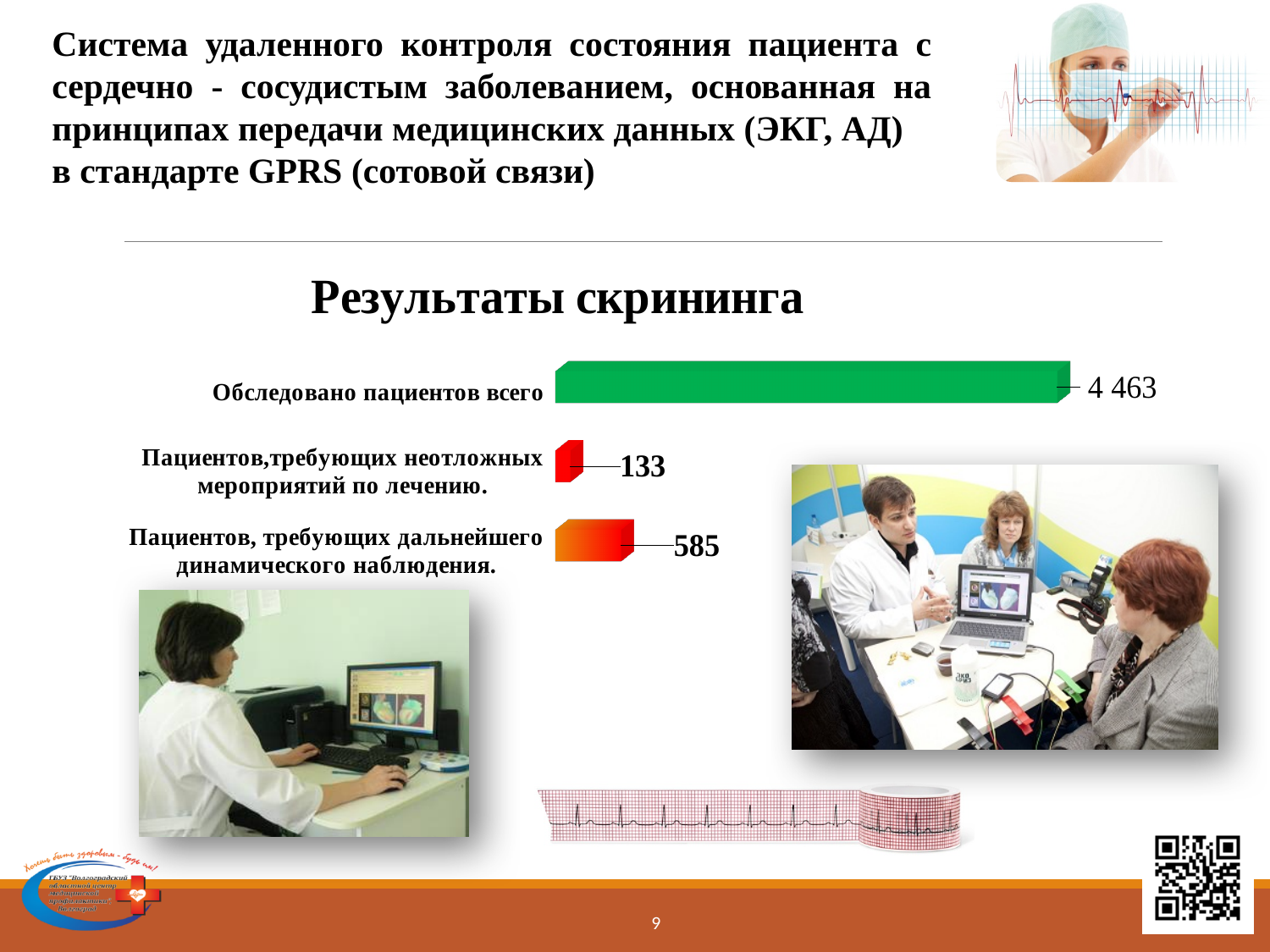
What is the difference between the value for "Пациентов, требующих дальнейшего динамического наблюдения" and the value for "Пациентов, требующих неотложных мероприятий по лечению"? 452 Which category has the lowest value? Пациентов, требующих неотложных мероприятий по лечению What is the title of the chart? Результаты скрининга What is the difference between the value for "Обследовано пациентов всего" and the value for "Пациентов, требующих дальнейшего динамического наблюдения"? 3 878 Which category has the highest value? Обследовано пациентов всего What is the value for "Пациентов, требующих дальнейшего динамического наблюдения"? 585 What is the value for "Обследовано пациентов всего"? 4 463 Which is larger: the value for "Пациентов, требующих неотложных мероприятий по лечению" or the value for "Пациентов, требующих дальнейшего динамического наблюдения"? Пациентов, требующих дальнейшего динамического наблюдения How many categories does the chart show? 3 What colour is the bar for "Обследовано пациентов всего"? Green What is the value for "Пациентов, требующих неотложных мероприятий по лечению"? 133 What kind of chart is shown on the slide? Bar chart